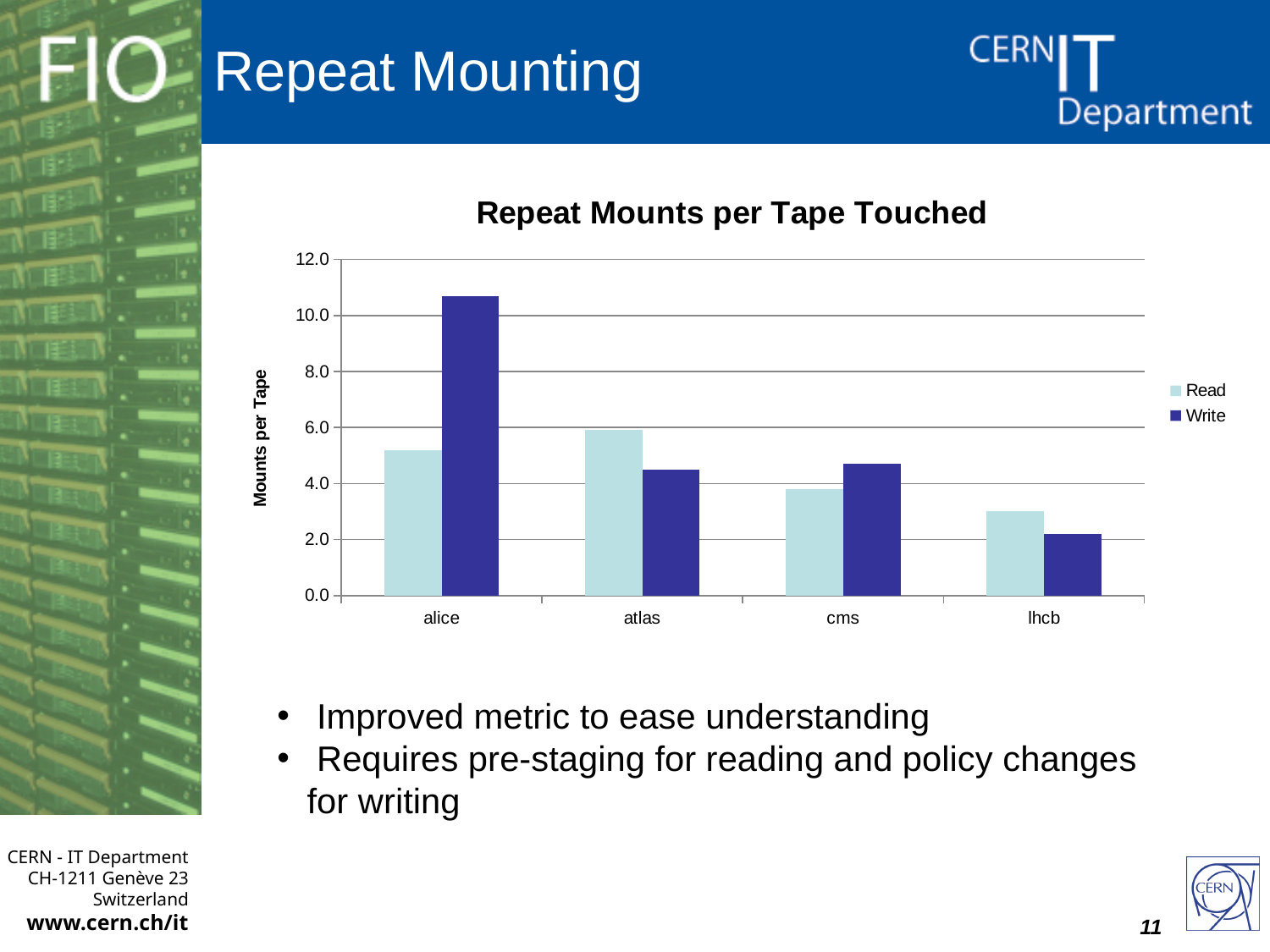
Which category has the lowest Write value? lhcb How many categories are shown on the x axis of the chart? 4 What is the title of the chart? Repeat Mounts per Tape Touched Is the Read value for lhcb greater or less than 4.0? less What kind of chart is shown on the slide? bar chart Which category has the highest Write value? alice For alice, which is larger, the Read value or the Write value? Write Is the Write value for alice greater or less than 10.0? greater How many series does the chart's legend list? 2 Which category has the lowest Read value? lhcb For atlas, which is larger, the Read value or the Write value? Read Which category has the highest Read value? atlas